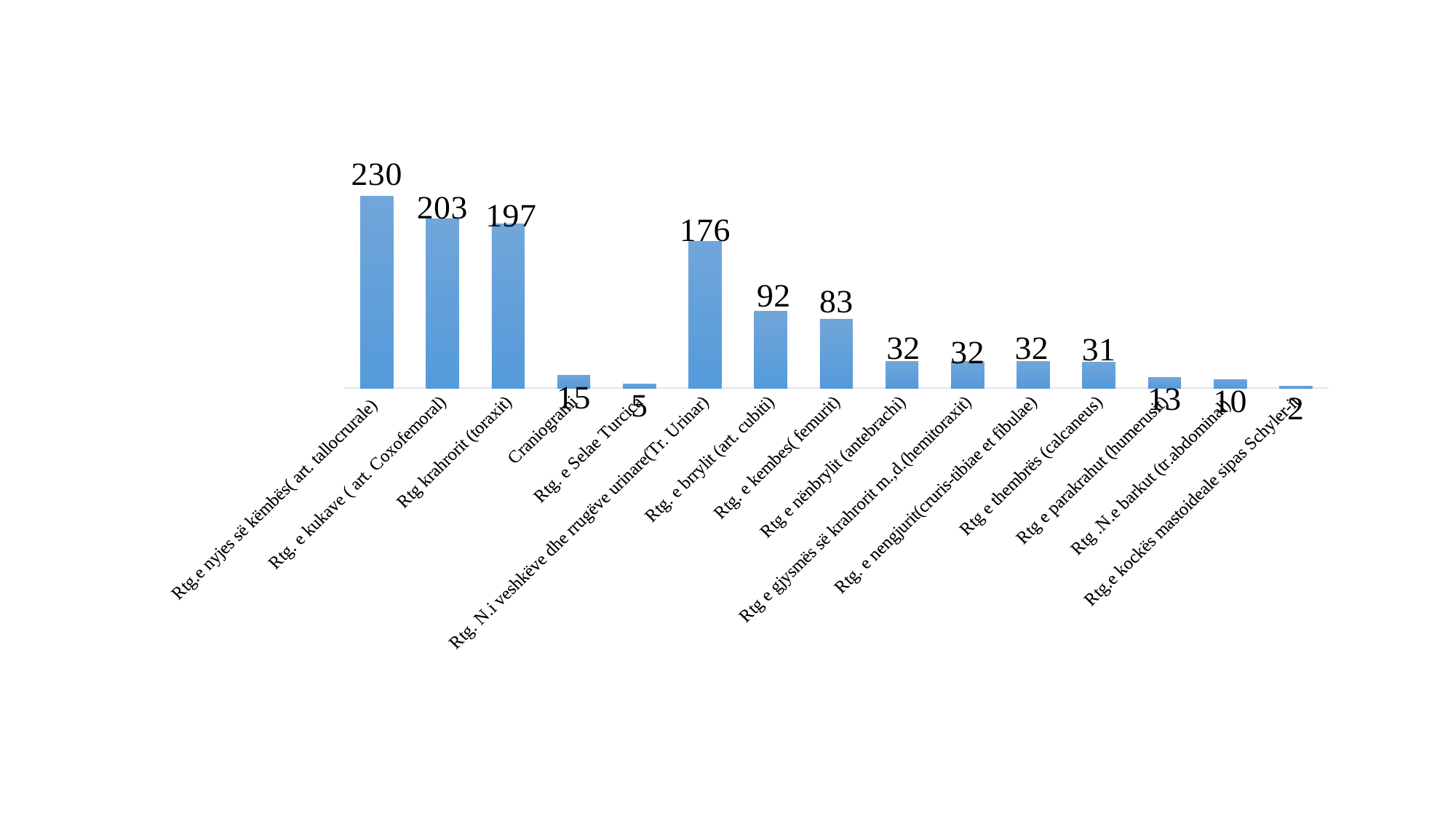
What is the value for Rtg e thembrës (calcaneus)? 31 What is the value for Rtg krahrorit (toraxit)? 197 What is the difference between the values for Craniogram and Rtg. e Selae Turcice? 10 What is the difference between the values for Rtg. e kukave (art. Coxofemoral) and Rtg krahrorit (toraxit)? 6 What is the value for Rtg.e nyjes së këmbës (art. tallocrurale)? 230 What type of chart is shown on the slide? bar chart Which category has the lowest value? Rtg.e kockës mastoideale sipas Schyler-it What is the value for Rtg. N.i veshkëve dhe rrugëve urinare (Tr. Urinar)? 176 Which category has the highest value? Rtg.e nyjes së këmbës (art. tallocrurale) Which is larger, the value for Rtg. e brrylit (art. cubiti) or the value for Rtg. e kembes (femurit)? Rtg. e brrylit (art. cubiti) What is the value for Rtg. e Selae Turcice? 5 How many categories (bars) are shown in the chart? 15